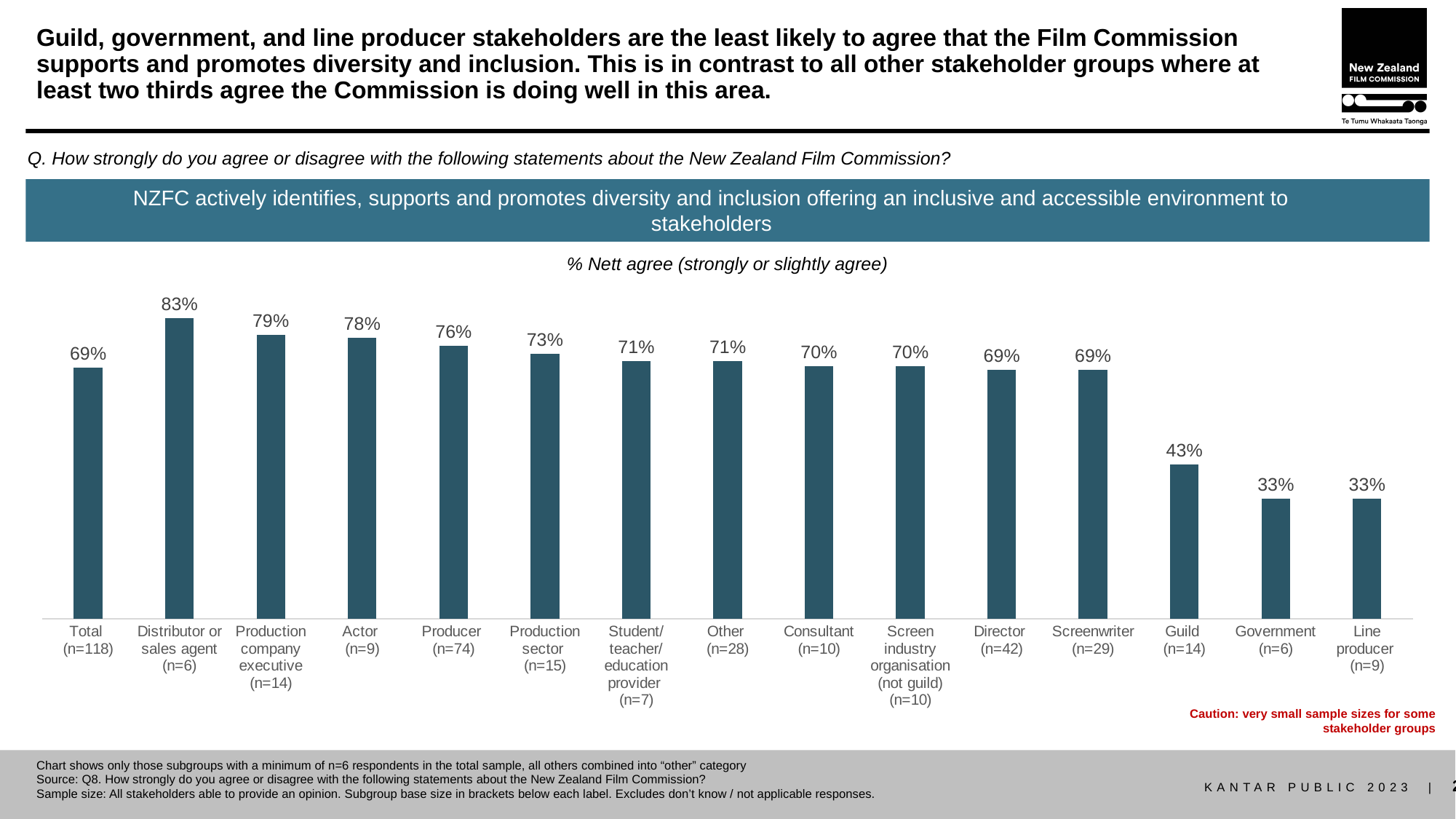
What is the % Nett agree value for Producer? 76% What is the % Nett agree value for Guild? 43% What is the % Nett agree value for Distributor or sales agent? 83% What is the % Nett agree value for Total (n=118)? 69% What is the difference in % Nett agree between Actor and Government? 45% Which has a higher % Nett agree, Guild or Director? Director Which stakeholder group has the highest % Nett agree? Distributor or sales agent What is the sample size shown for the Producer group? n=74 How many stakeholder groups (bars) are shown in the chart? 15 What is the difference in % Nett agree between Distributor or sales agent and Guild? 40% What type of chart is shown on the slide? Bar chart Which has a higher % Nett agree, Production company executive or Screenwriter? Production company executive